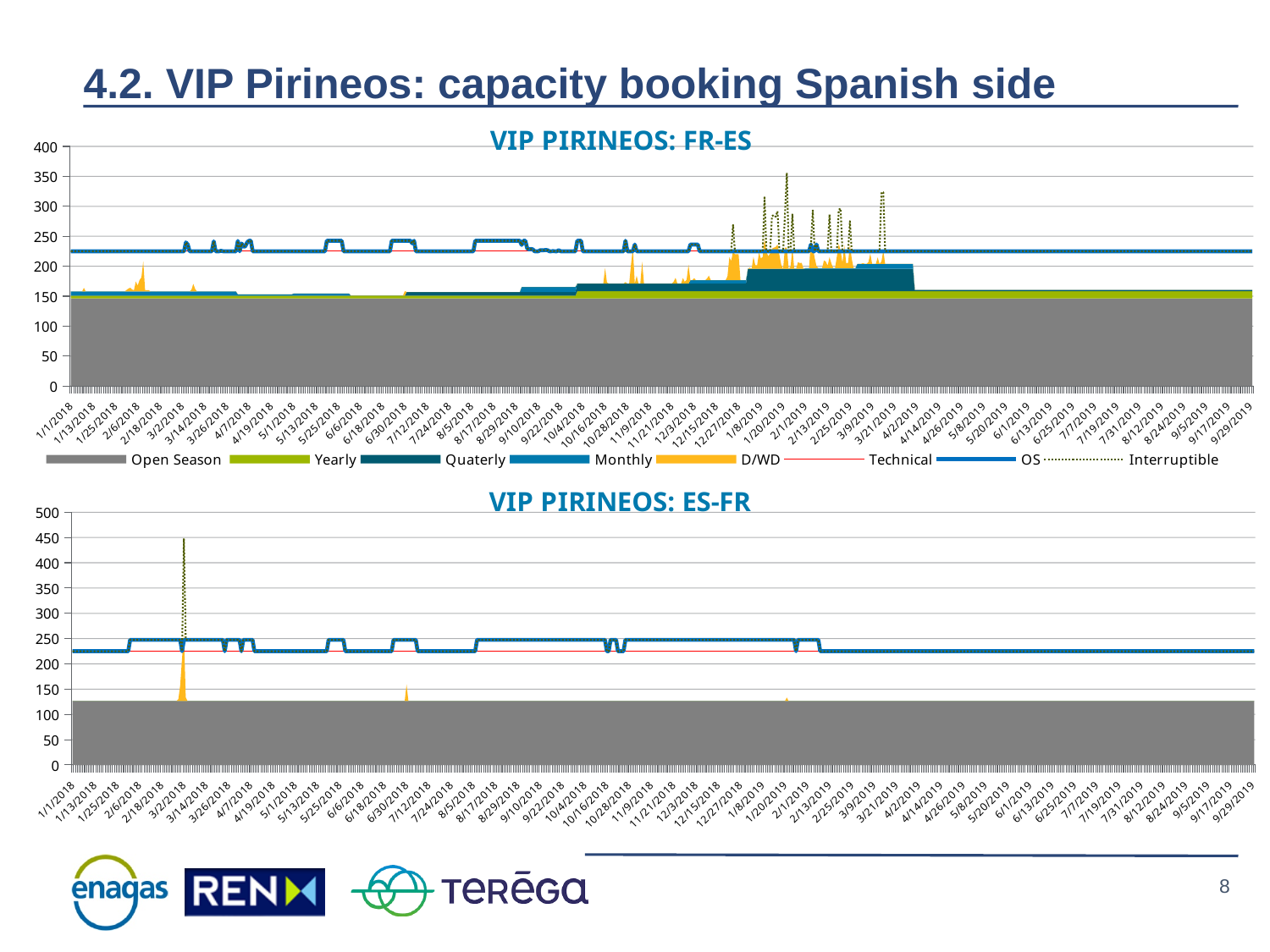
In the VIP PIRINEOS: ES-FR chart, is the grey Open Season area greater or less than 100? greater What is the maximum value shown on the y axis of the VIP PIRINEOS: ES-FR chart? 500 What is the title of the bottom chart on the slide? VIP PIRINEOS: ES-FR How many series does the legend of the VIP PIRINEOS: FR-ES chart list? 8 In the VIP PIRINEOS: ES-FR chart, is the grey Open Season area greater or less than 150? less In the VIP PIRINEOS: FR-ES chart, is the Open Season value greater or less than 100? greater What is the title of the top chart on the slide? VIP PIRINEOS: FR-ES In the VIP PIRINEOS: FR-ES chart, which is larger: the Open Season value or the Technical line value? Technical What kind of chart is the VIP PIRINEOS: FR-ES chart? Area chart with lines